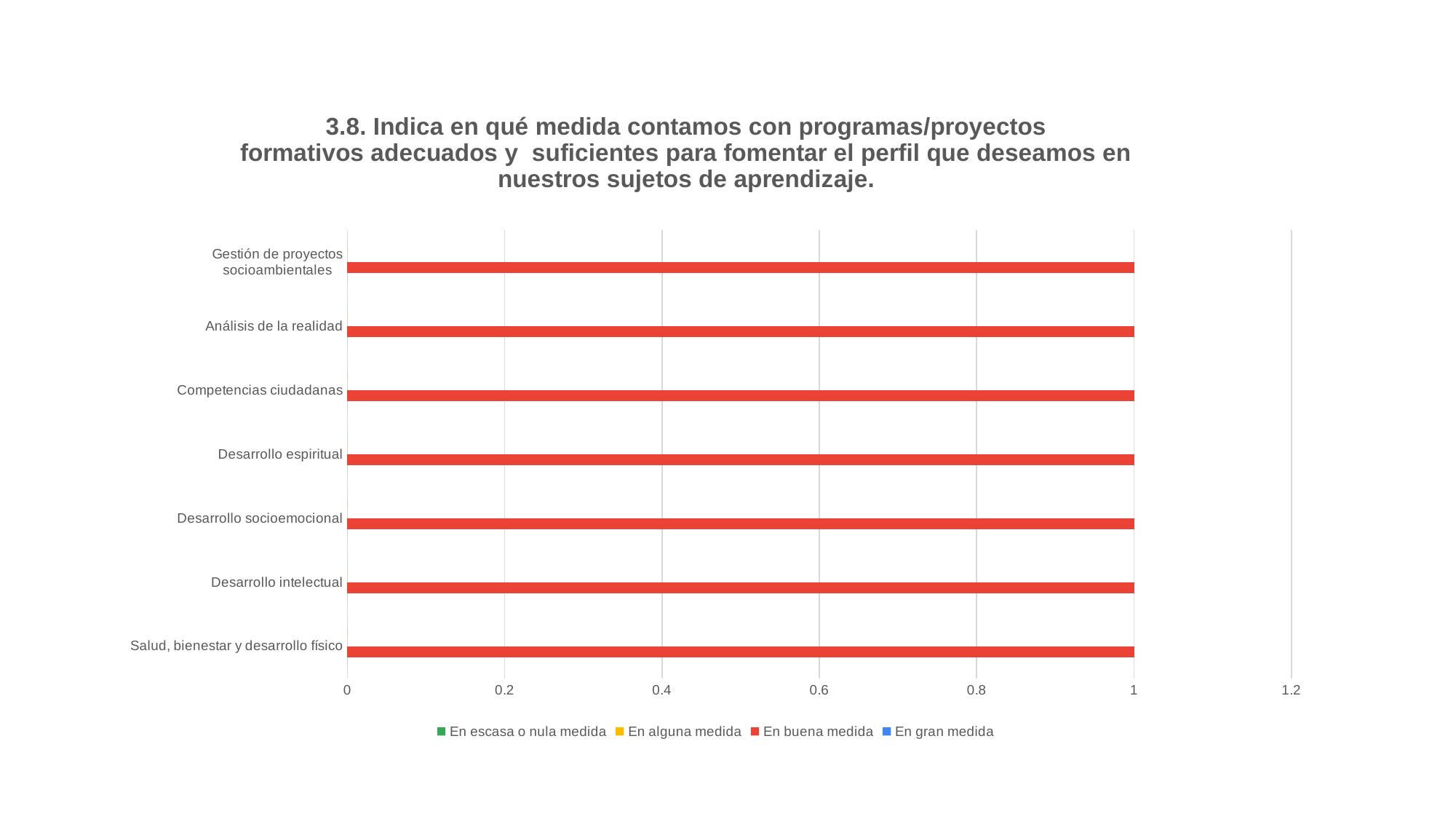
Which legend entry is shown in red? En buena medida What is the value of the 'En buena medida' bar for 'Análisis de la realidad'? 1 What is the value of the 'En buena medida' bar for 'Salud, bienestar y desarrollo físico'? 1 How many categories are listed on the vertical axis of the chart? 7 Is the 'En buena medida' value for 'Desarrollo espiritual' greater or less than 1.2? less What is the value of the 'En buena medida' bar for 'Desarrollo intelectual'? 1 Which category is listed at the top of the vertical axis? Gestión de proyectos socioambientales How many series does the chart legend list? 4 What is the difference between the 'En buena medida' values for 'Gestión de proyectos socioambientales' and 'Desarrollo socioemocional'? 0 What is the highest value shown on the horizontal axis? 1.2 What kind of chart is shown on the slide? bar chart Is the 'En buena medida' value for 'Competencias ciudadanas' greater or less than 0.8? greater